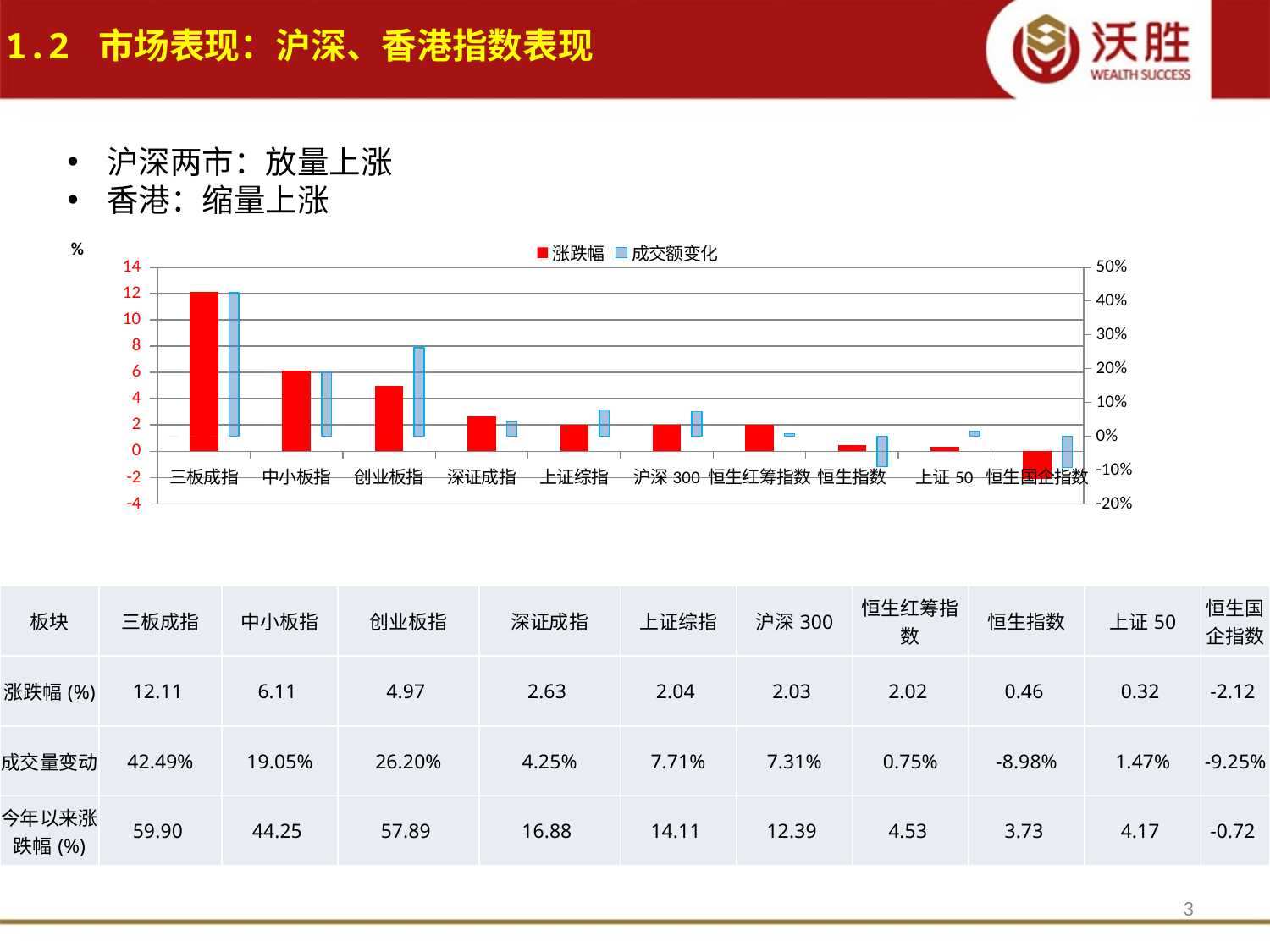
Which has the larger 涨跌幅, 中小板指 or 创业板指? 中小板指 Which index has the highest 涨跌幅 in the chart? 三板成指 Is the 成交额变化 value for 恒生指数 greater or less than 0%? less What kind of chart is shown on the slide? bar chart Is the 成交额变化 value for 创业板指 greater or less than 20%? greater Is the 涨跌幅 value for 三板成指 greater or less than 10? greater Which index has the lowest 涨跌幅 in the chart? 恒生国企指数 What are the two series named in the chart legend? 涨跌幅 and 成交额变化 How many index categories are plotted along the x axis of the chart? 10 Which index has the highest 成交额变化 in the chart? 三板成指 According to the table below the chart, what is the 涨跌幅 (%) for 三板成指? 12.11 How many series does the chart legend list? 2